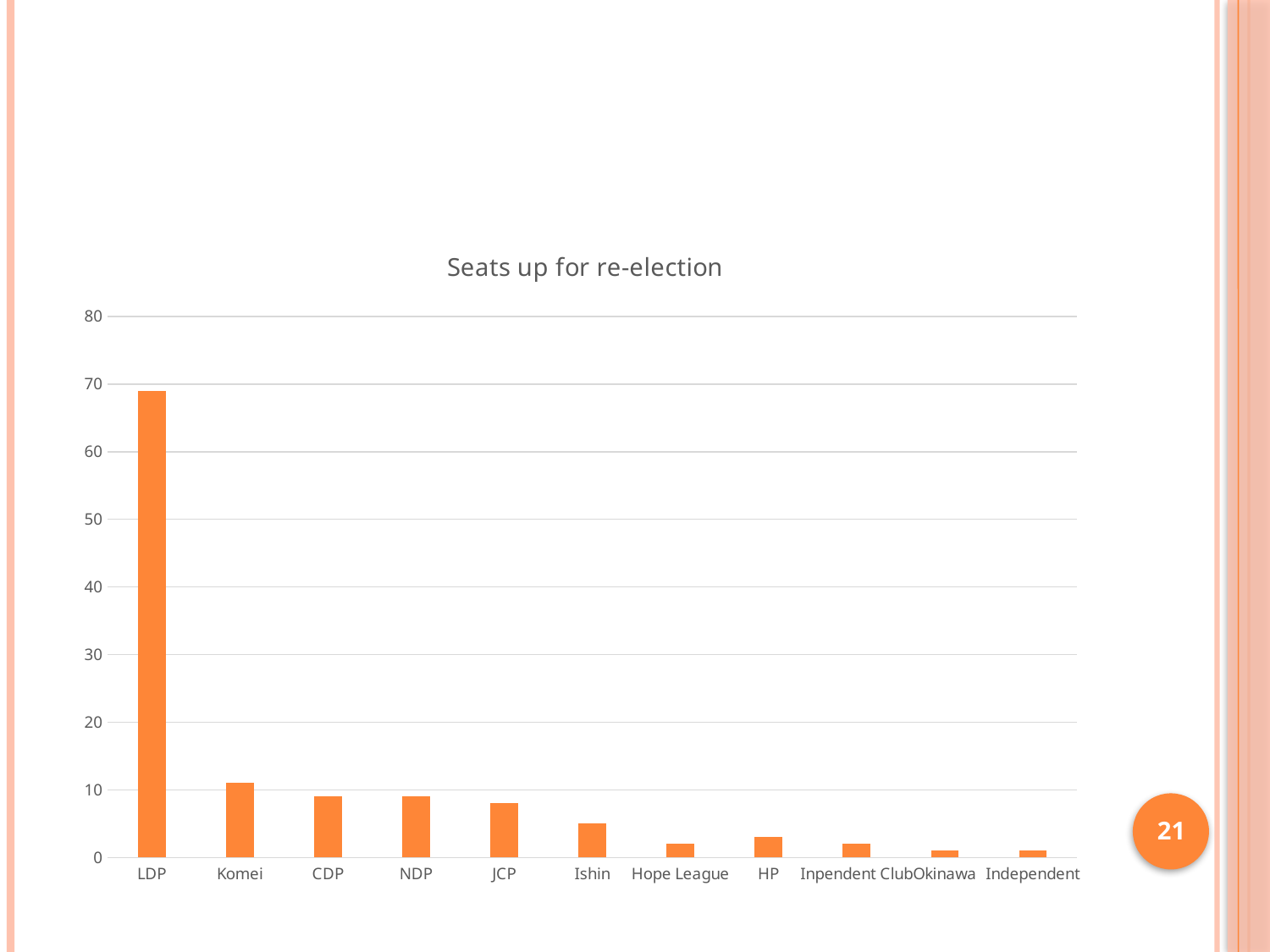
Which has more seats up for re-election, LDP or Komei? LDP Is the value for Hope League greater or less than 10? less Which has more seats up for re-election, JCP or Hope League? JCP Is the value for Komei greater or less than 20? less Is the value for JCP greater or less than 10? less Which has more seats up for re-election, Komei or Ishin? Komei Which party has the highest number of seats up for re-election? LDP How many parties (categories) are shown on the x axis of the chart? 11 What is the title of the chart? Seats up for re-election What kind of chart is shown on the slide? bar chart